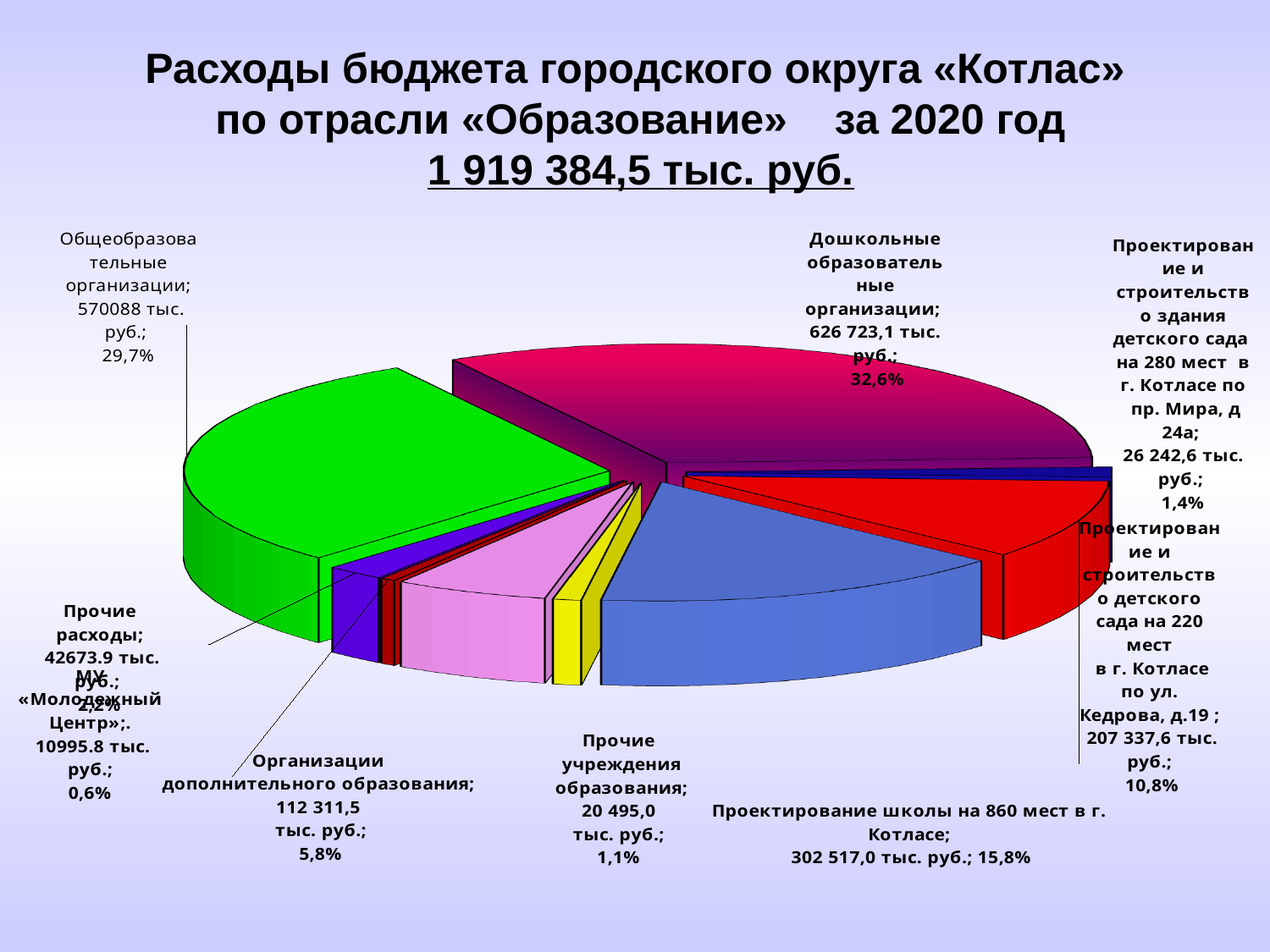
What is the value for «Проектирование школы на 860 мест в г. Котласе»? 302 517,0 тыс. руб. Which category has the smallest share of the pie? МУ «Молодежный Центр» What share of the pie is taken by «Дошкольные образовательные организации»? 32,6% What is the total amount of expenditure shown in the chart title? 1 919 384,5 тыс. руб. What is the difference in percentage points between the share of «Дошкольные образовательные организации» (32,6%) and «Общеобразовательные организации» (29,7%)? 2,9 What type of chart is shown on the slide? Pie chart What percentage share does «Организации дополнительного образования» have? 5,8% What is the value for «Общеобразовательные организации» in тыс. руб.? 570088 тыс. руб. What is the percentage share for the construction of the kindergarten for 220 places on ул. Кедрова, д.19? 10,8% Which is larger: the share for «Прочие расходы» or the share for «Прочие учреждения образования»? Прочие расходы How many categories (slices) does the pie chart have? 9 Which category has the largest share of the pie? Дошкольные образовательные организации